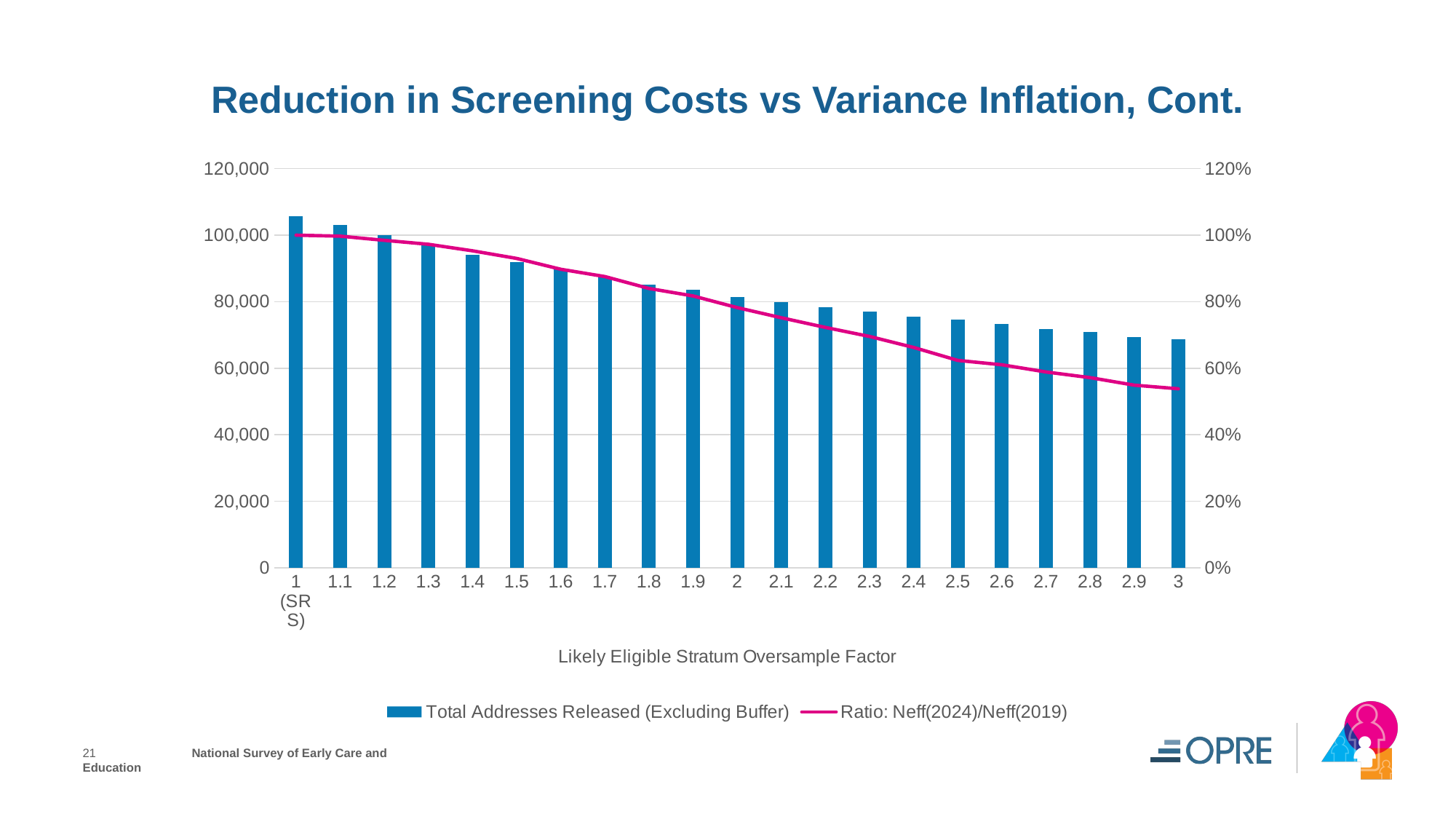
Which has the larger Total Addresses Released value, oversample factor 1.2 or 2.8? 1.2 How many oversample factor categories are plotted along the x axis? 21 Which oversample factor has the lowest value for Total Addresses Released (Excluding Buffer)? 3 Is the Total Addresses Released value at oversample factor 3 greater or less than 80,000? less Do the Total Addresses Released values rise or fall as the oversample factor increases from 1 (SRS) to 3? Fall Which oversample factor has the highest value for Total Addresses Released (Excluding Buffer)? 1 (SRS) What is the title of the x axis? Likely Eligible Stratum Oversample Factor Is the Ratio: Neff(2024)/Neff(2019) at oversample factor 3 greater or less than 60%? less How many series does the legend list? 2 What kind of chart is shown on the slide? A combination bar and line chart Is the Ratio: Neff(2024)/Neff(2019) at oversample factor 1.8 greater or less than 80%? greater